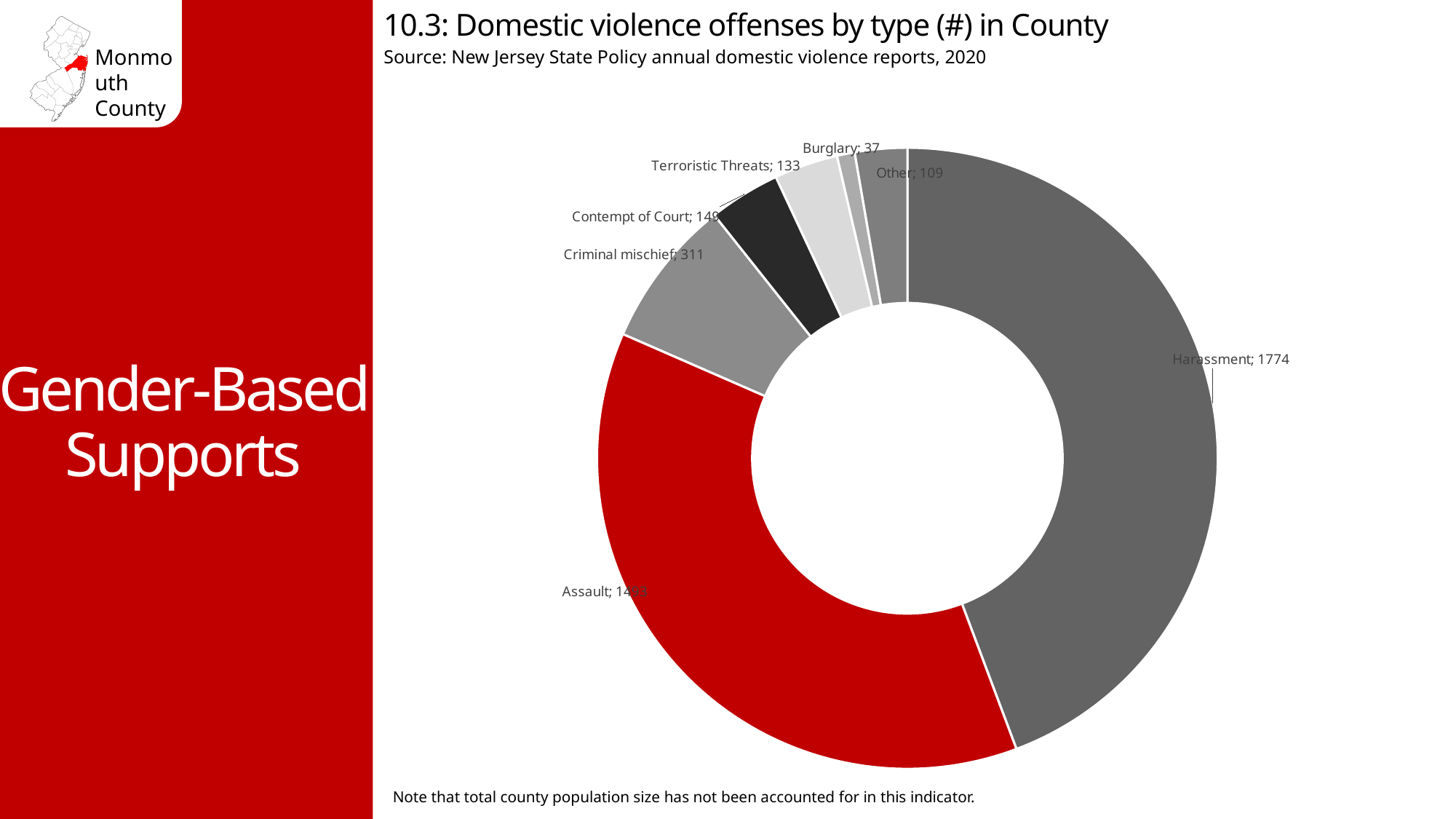
What is the value for the Other category on the chart? 109 What is the number of Terroristic Threats offenses shown on the chart? 133 How many offense categories are shown on the chart? 7 What type of chart is used on this slide? Doughnut (pie) chart What is the number of Burglary offenses shown on the chart? 37 How many more Harassment offenses are there than Criminal mischief offenses? 1463 What is the number of Contempt of Court offenses shown on the chart? 149 What is the number of Harassment offenses shown on the chart? 1774 Which has more offenses, Contempt of Court or Terroristic Threats? Contempt of Court What is the number of Criminal mischief offenses shown on the chart? 311 Which offense type has the highest number of offenses? Harassment Which offense type has the lowest number of offenses? Burglary